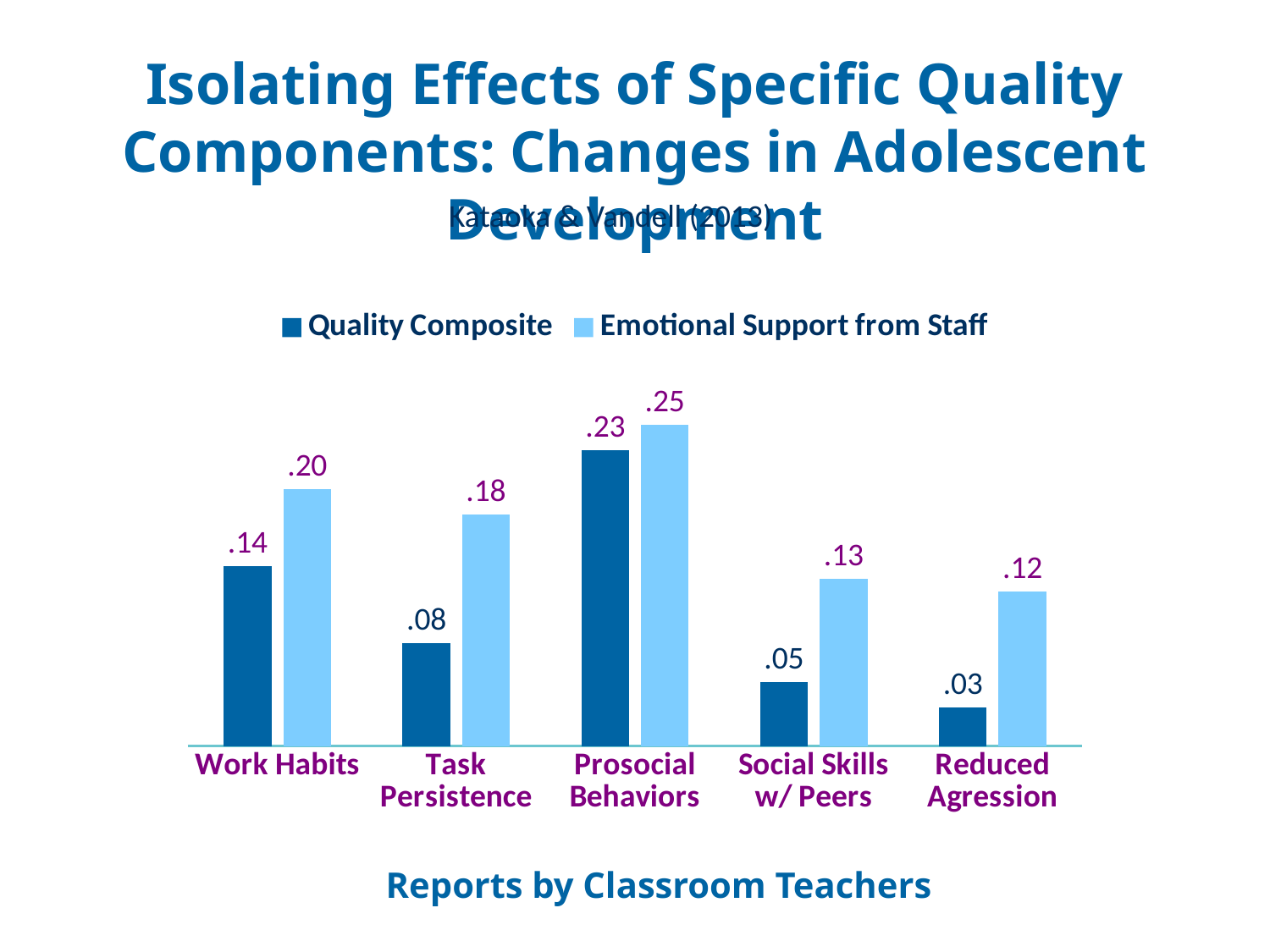
What kind of chart is shown on the slide? Bar chart Which category has the highest Emotional Support from Staff value? Prosocial Behaviors What is the difference between the Emotional Support from Staff and Quality Composite values for Social Skills w/ Peers? .08 What is the difference between the Emotional Support from Staff values for Work Habits and Reduced Agression? .08 How many categories are shown on the x axis? 5 Which is larger for Prosocial Behaviors: Quality Composite or Emotional Support from Staff? Emotional Support from Staff What is the Quality Composite value for Reduced Agression? .03 What is the Quality Composite value for Work Habits? .14 What is the Emotional Support from Staff value for Task Persistence? .18 Which category has the lowest Quality Composite value? Reduced Agression How many series does the legend list? 2 What text appears below the chart? Reports by Classroom Teachers